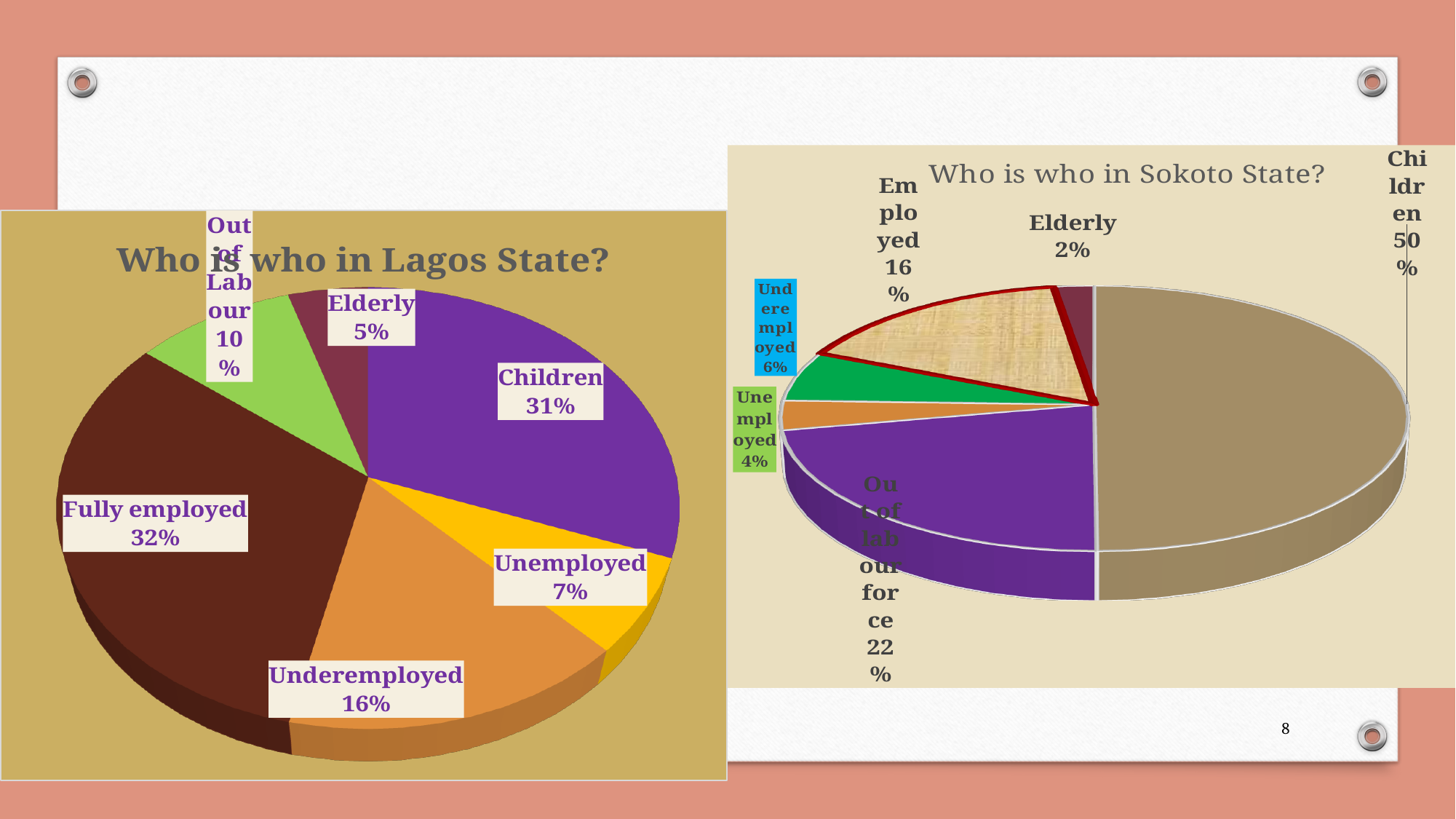
In the 'Who is who in Sokoto State?' chart, what is the difference between the Underemployed share and the Unemployed share? 2% In the 'Who is who in Sokoto State?' chart, what share is Out of labour force? 22% In the 'Who is who in Lagos State?' chart, what share is Underemployed? 16% In the 'Who is who in Lagos State?' chart, which category has the largest share? Fully employed In the 'Who is who in Lagos State?' chart, what is the difference between the Out of Labour share and the Unemployed share? 3% In the 'Who is who in Lagos State?' chart, which category has the smallest share? Elderly In the 'Who is who in Sokoto State?' chart, which category has the smallest share? Elderly How many slices does the 'Who is who in Lagos State?' chart have? 6 What type of chart is 'Who is who in Sokoto State?'? Pie chart In the 'Who is who in Sokoto State?' chart, what share is Children? 50% In the 'Who is who in Sokoto State?' chart, which is larger, Employed or Underemployed? Employed In the 'Who is who in Lagos State?' chart, what share is Children? 31%